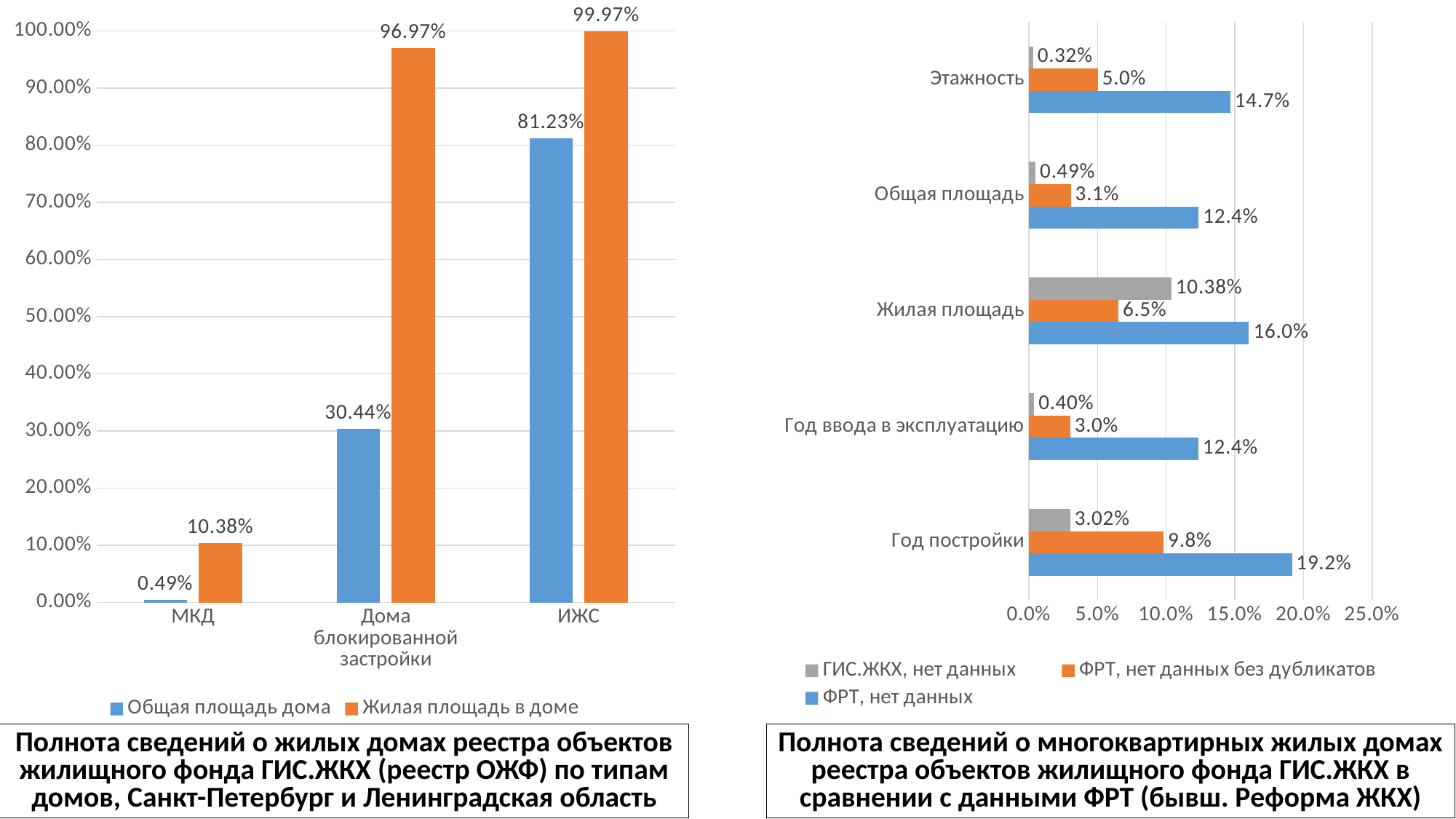
On the left chart, what is the value of Общая площадь дома for ИЖС? 81.23% On the left chart, how many categories are shown on the x axis? 3 On the left chart, what is the value of Жилая площадь в доме for Дома блокированной застройки? 96.97% On the right chart, how many series does the legend list? 3 On the right chart, which category has the highest value for ФРТ, нет данных без дубликатов? Год постройки On the right chart, what is the difference between ФРТ, нет данных and ГИС.ЖКХ, нет данных for Год постройки? 16.18% On the left chart, which category has the lowest value for Общая площадь дома? МКД On the left chart, what is the difference between Жилая площадь в доме and Общая площадь дома for МКД? 9.89% On the right chart, what is the value of ФРТ, нет данных for Год постройки? 19.2% What kind of chart is the left chart? Bar chart On the right chart, which is larger for Этажность: ФРТ, нет данных or ФРТ, нет данных без дубликатов? ФРТ, нет данных On the right chart, what is the value of ГИС.ЖКХ, нет данных for Жилая площадь? 10.38%